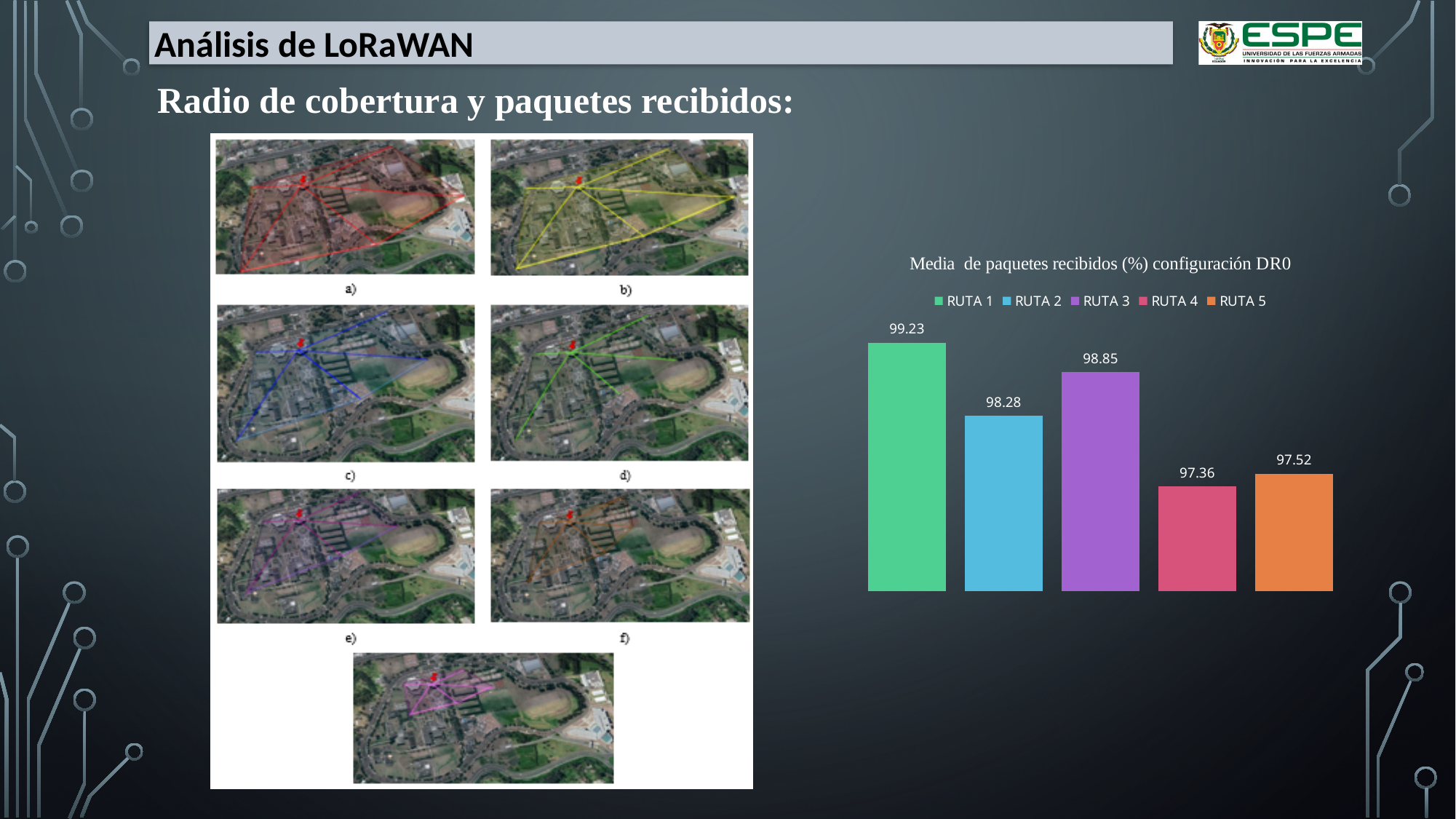
What is the difference between the values for RUTA 3 and RUTA 5? 1.33 What is the title of the chart? Media de paquetes recibidos (%) configuración DR0 Which route has the lowest mean of received packets? RUTA 4 Which route has the highest mean of received packets? RUTA 1 Which is larger, the value for RUTA 2 or the value for RUTA 3? RUTA 3 What is the value for RUTA 1? 99.23 How many bars are shown in the chart? 5 What is the difference between the values for RUTA 1 and RUTA 2? 0.95 How many series does the legend list? 5 What kind of chart is shown on the slide? Bar chart What is the value for RUTA 4? 97.36 What is the value for RUTA 3? 98.85